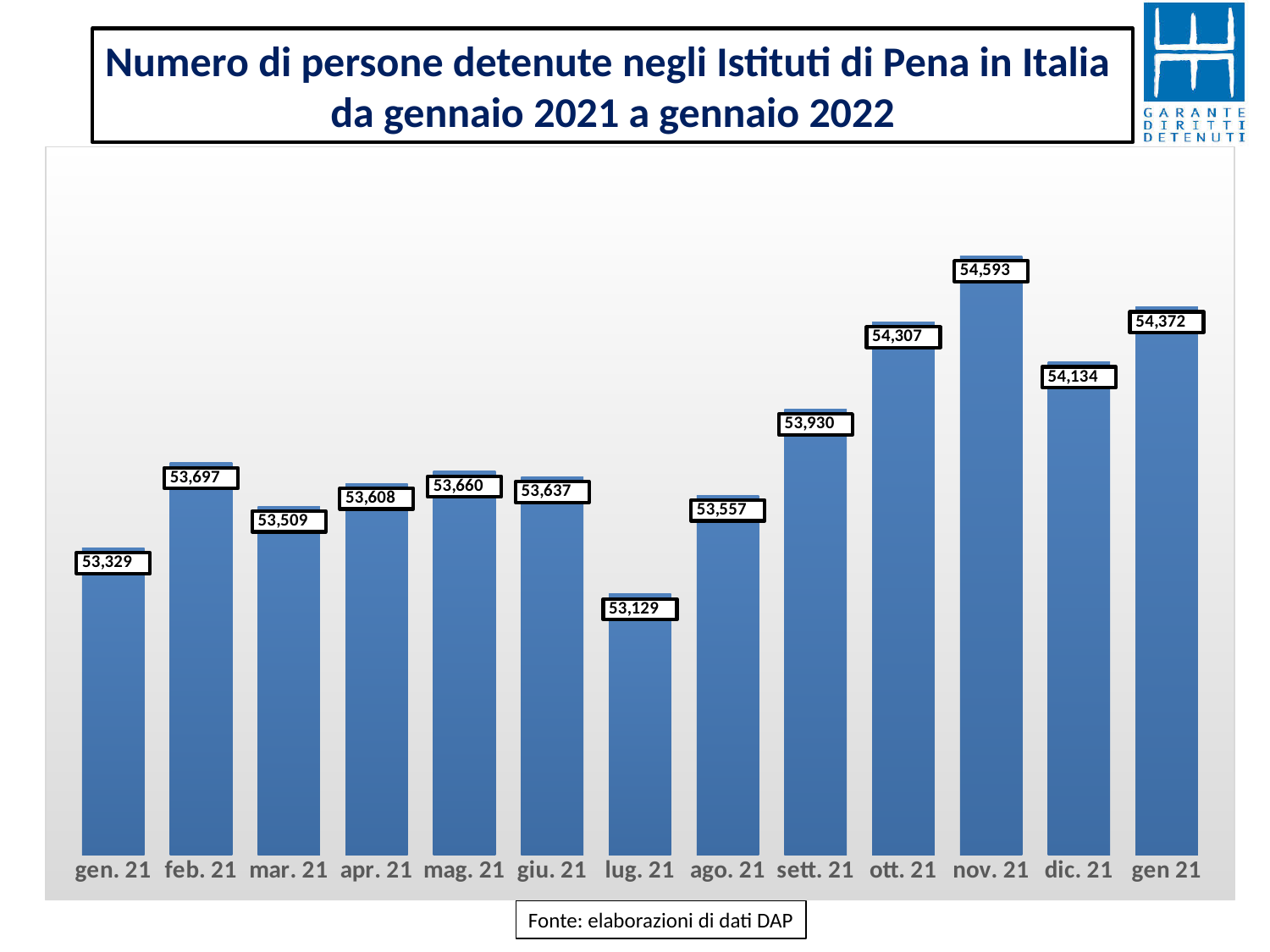
How many months are shown on the x axis? 13 What is the difference between the values for nov. 21 and lug. 21? 1,464 Which month has the highest value? nov. 21 Do the values rise or fall from lug. 21 to nov. 21? rise What is the difference between the values for gen 21 (January 2022) and gen. 21 (January 2021)? 1,043 Which is larger, the value for ott. 21 or the value for dic. 21? ott. 21 What is the value for gen. 21? 53,329 What is the value for nov. 21? 54,593 What is the value for lug. 21? 53,129 What is the title of the chart? Numero di persone detenute negli Istituti di Pena in Italia da gennaio 2021 a gennaio 2022 What kind of chart is shown on the slide? bar chart Which month has the lowest value? lug. 21